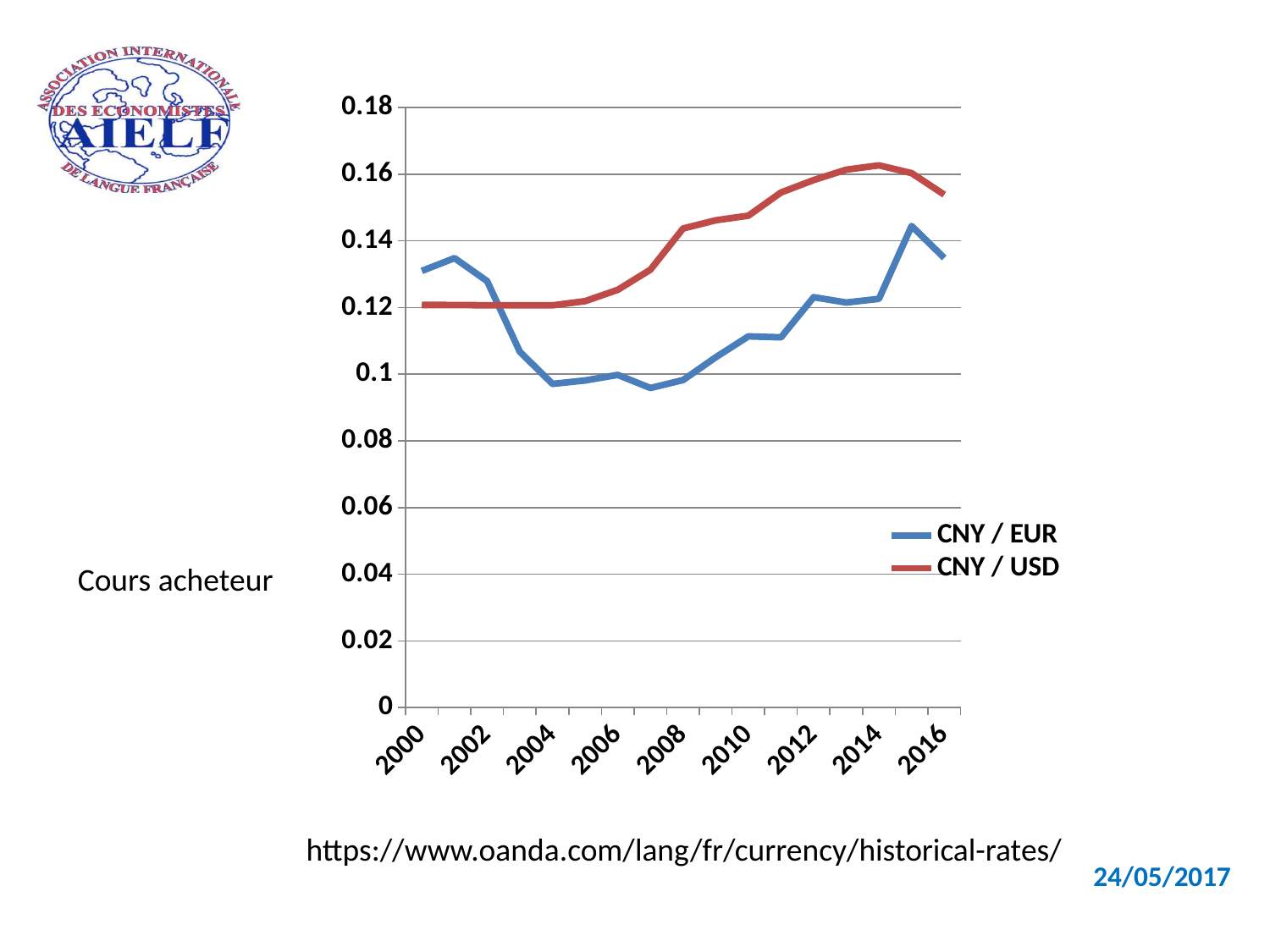
Is the value for CNY / USD in 2014 greater or less than 0.14? greater What kind of chart is shown on the slide? line chart Is the value for CNY / EUR in 2015 greater or less than 0.12? greater How many series does the legend list? 2 Which series reaches the highest value anywhere on the chart? CNY / USD Does the CNY / EUR line rise or fall between 2002 and 2004? fall In 2010, which series has the higher value, CNY / EUR or CNY / USD? CNY / USD Is the value for CNY / USD in 2004 greater or less than 0.14? less Does the CNY / USD line rise or fall between 2008 and 2014? rise What are the two series named in the legend? CNY / EUR and CNY / USD Which series is drawn in red? CNY / USD